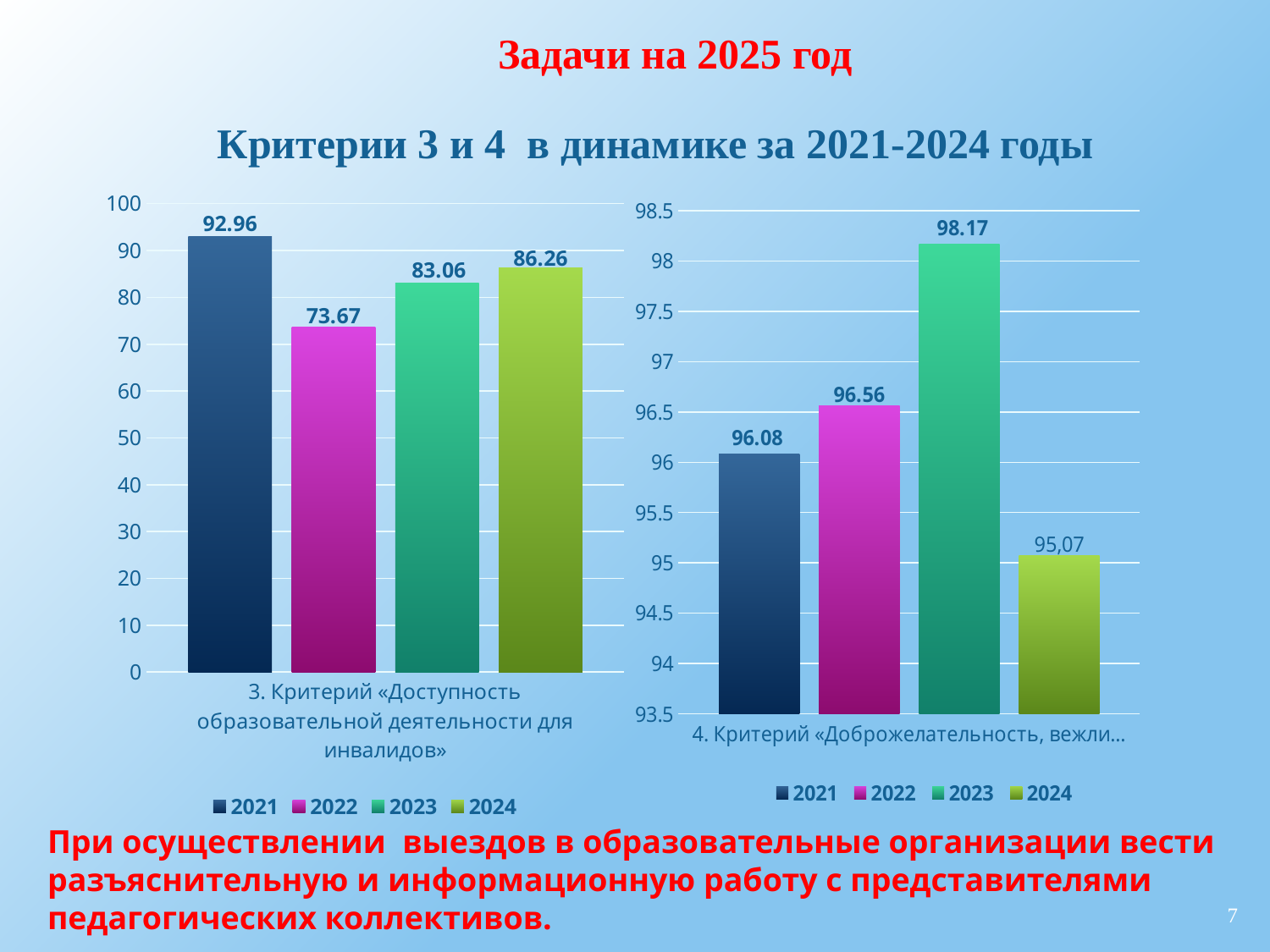
In the right chart (Criterion 4), what is the value for 2023? 98.17 In the right chart (Criterion 4), is the value for 2022 greater or less than 96.5? greater In the left chart (Criterion 3), what is the value for 2022? 73.67 In the left chart (Criterion 3), which is larger, the value for 2023 or the value for 2024? 2024 In the left chart (Criterion 3), what is the value for 2021? 92.96 What type of chart is the left chart? Bar chart In the right chart (Criterion 4), what is the value for 2024? 95,07 In the left chart (Criterion 3), what is the difference between the 2021 and 2022 values? 19.29 How many series does the legend of the right chart list? 4 In the right chart (Criterion 4), what is the difference between the 2023 and 2021 values? 2.09 In the right chart (Criterion 4), which year has the highest value? 2023 In the left chart (Criterion 3), which year has the lowest value? 2022